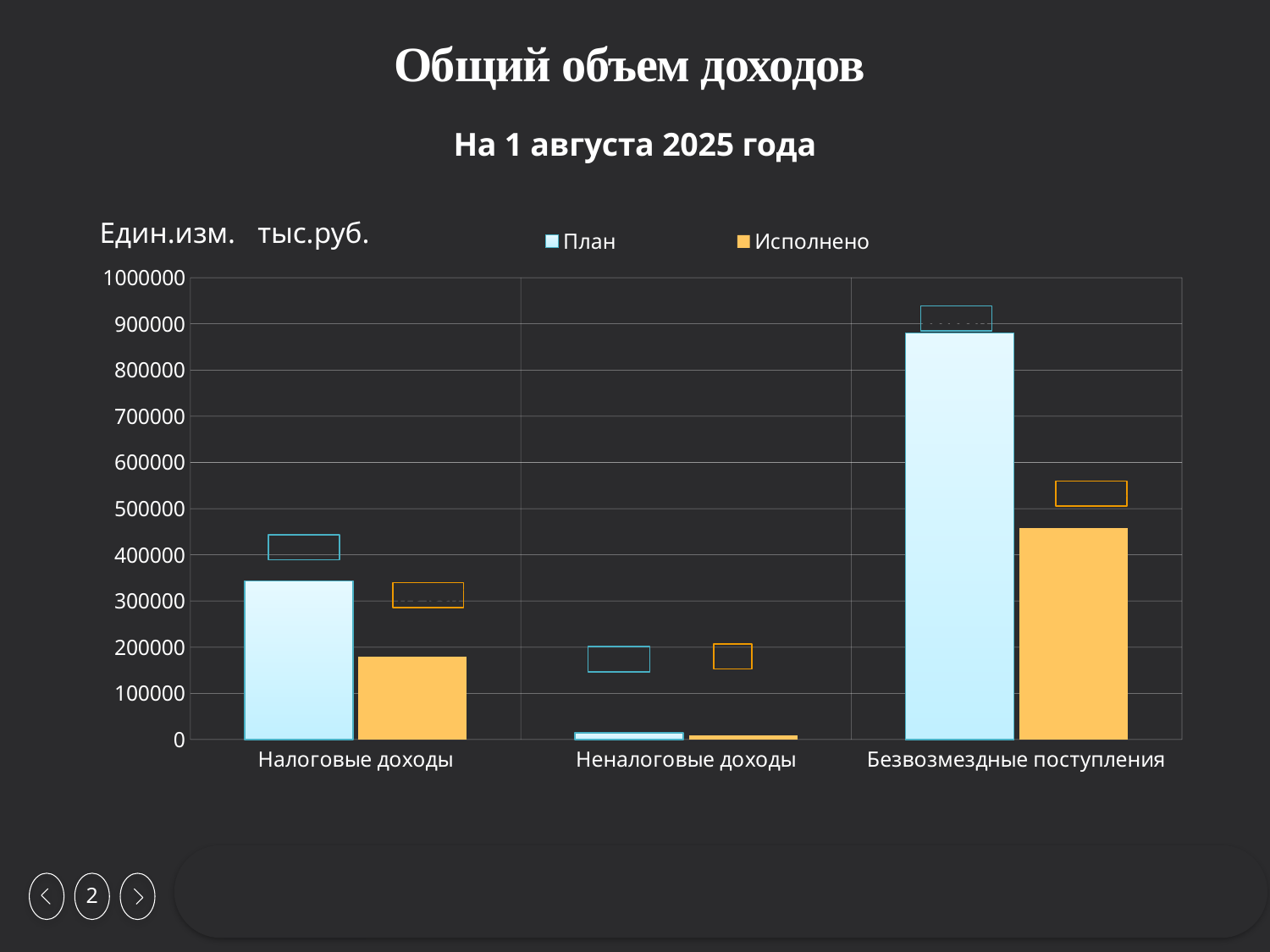
Which is larger for Безвозмездные поступления, the План value or the Исполнено value? План Is the Исполнено value for Безвозмездные поступления greater or less than 500000? less Is the План value for Налоговые доходы greater or less than 300000? greater Is the Исполнено value for Налоговые доходы greater or less than 200000? less Which category has the highest План value? Безвозмездные поступления How many series does the legend list? 2 What unit of measurement is stated on the chart? тыс.руб. How many categories are shown on the x axis? 3 Which is larger, the Исполнено value for Налоговые доходы or the Исполнено value for Неналоговые доходы? Налоговые доходы What kind of chart is shown on the slide? bar chart Which category has the lowest Исполнено value? Неналоговые доходы